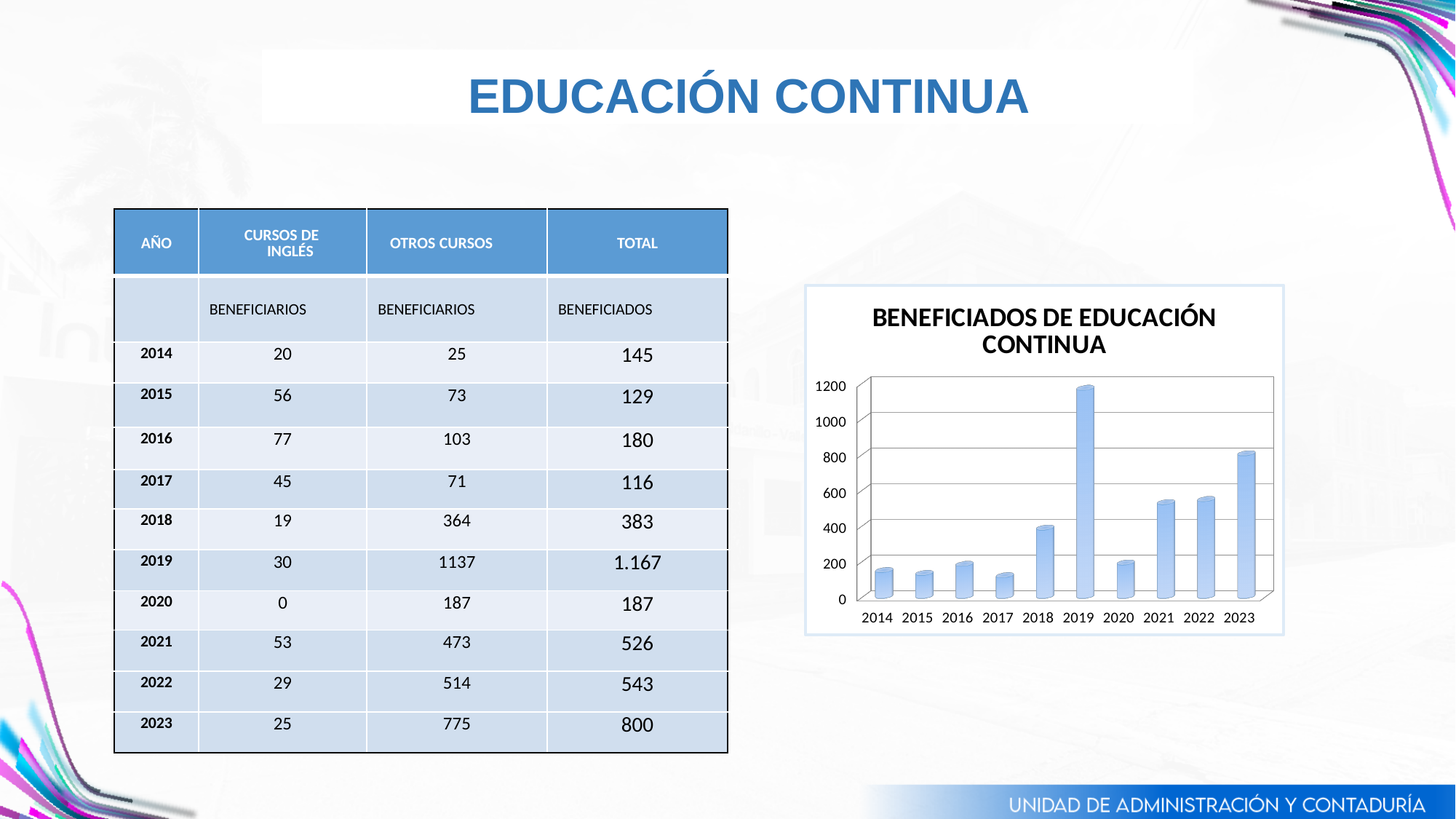
Is the value for 2018 greater or less than 400? less What is the value for 2023 in the chart? 800 Which year has the highest bar in the chart? 2019 Is the value for 2019 greater or less than 1000? greater Is the value for 2021 greater or less than 400? greater Which year has the lowest bar in the chart? 2017 Which is larger, the value for 2023 or the value for 2022? 2023 What is the title of the chart? BENEFICIADOS DE EDUCACIÓN CONTINUA What type of chart is shown on the slide? bar chart How many years are plotted on the x axis of the chart? 10 Which is larger, the value for 2018 or the value for 2020? 2018